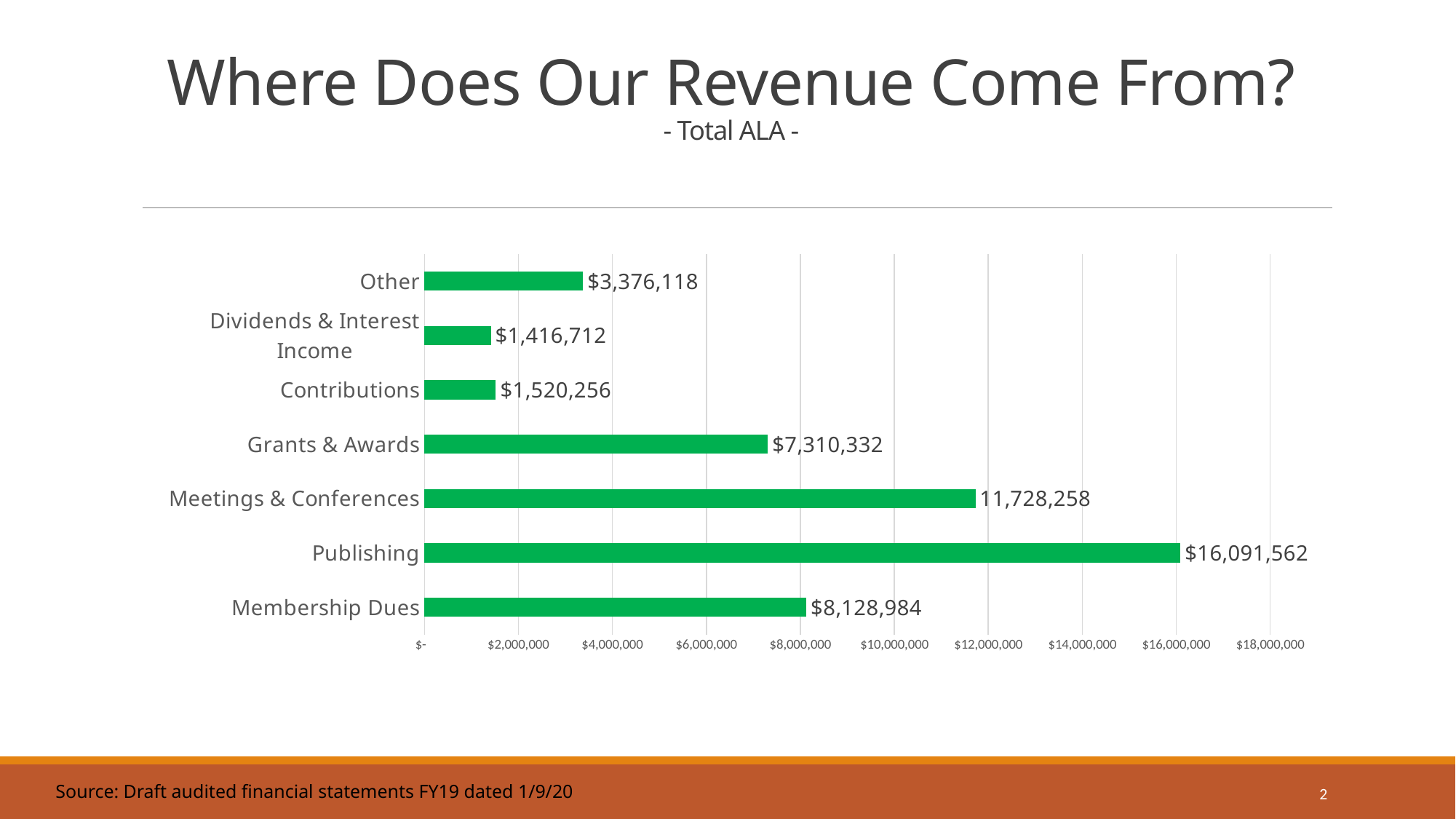
Which category has the lowest revenue? Dividends & Interest Income What is the difference between Contributions and Dividends & Interest Income? $103,544 Which category has the highest revenue? Publishing What is the value for Membership Dues? $8,128,984 What is the value for Publishing? $16,091,562 How many revenue categories are shown in the chart? 7 What is the value for Grants & Awards? $7,310,332 What is the difference between Publishing and Membership Dues? $7,962,578 What is the value for Meetings & Conferences? 11,728,258 Which is larger, Meetings & Conferences or Membership Dues? Meetings & Conferences What kind of chart is shown on the slide? Bar chart What is the value for Other? $3,376,118